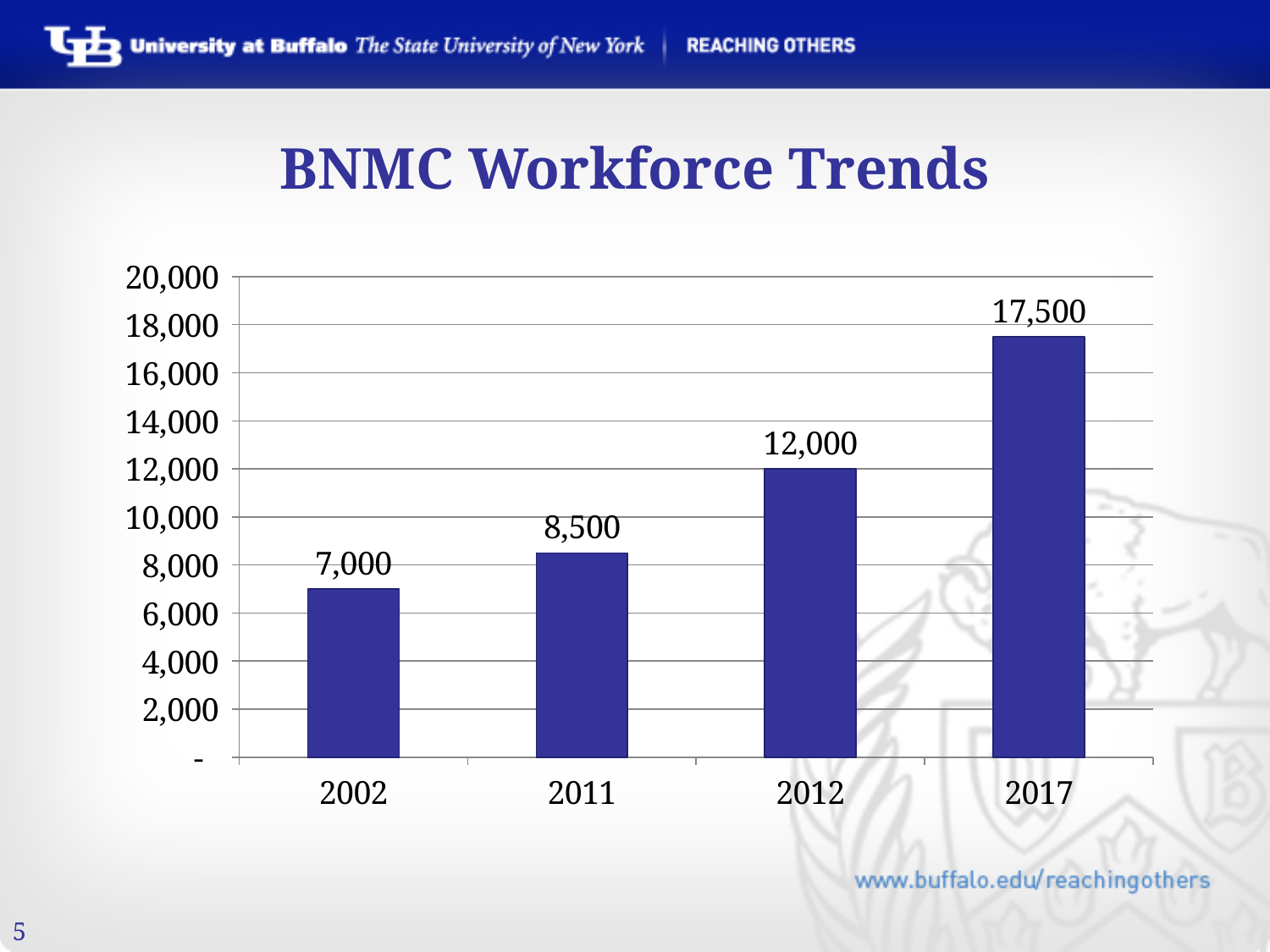
Which year has the lowest workforce value? 2002 What is the workforce value for 2012? 12,000 What is the workforce value for 2002? 7,000 Which is larger, the workforce value for 2011 or for 2012? 2012 What is the workforce value for 2011? 8,500 What is the difference between the workforce values for 2012 and 2011? 3,500 What kind of chart is shown on the slide? Bar chart What is the workforce value for 2017? 17,500 How many years are shown on the chart? 4 Do the workforce values rise or fall from 2002 to 2017? Rise What is the difference between the workforce values for 2017 and 2002? 10,500 Which year has the highest workforce value? 2017